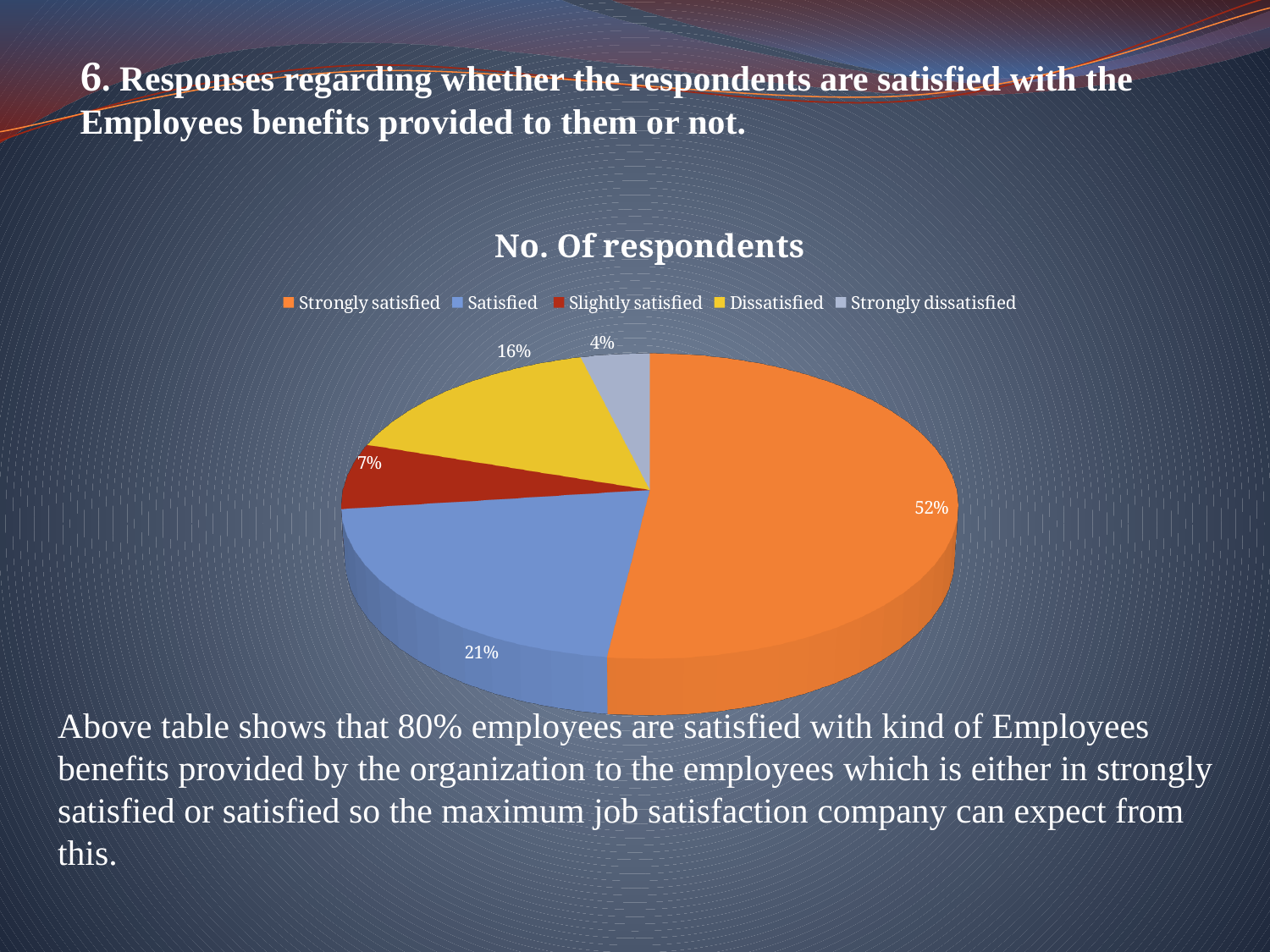
What percentage of respondents are Dissatisfied? 16% How many categories does the legend list? 5 Which is larger, the Dissatisfied share or the Slightly satisfied share? Dissatisfied What is the title of the chart? No. Of respondents What percentage of respondents are Strongly satisfied? 52% What percentage of respondents are Strongly dissatisfied? 4% What percentage of respondents are Satisfied? 21% Which category has the largest share of the pie? Strongly satisfied What type of chart is shown on the slide? Pie chart Which category has the smallest share of the pie? Strongly dissatisfied What is the difference between the Strongly satisfied and Satisfied shares? 31% What percentage of respondents are Slightly satisfied? 7%